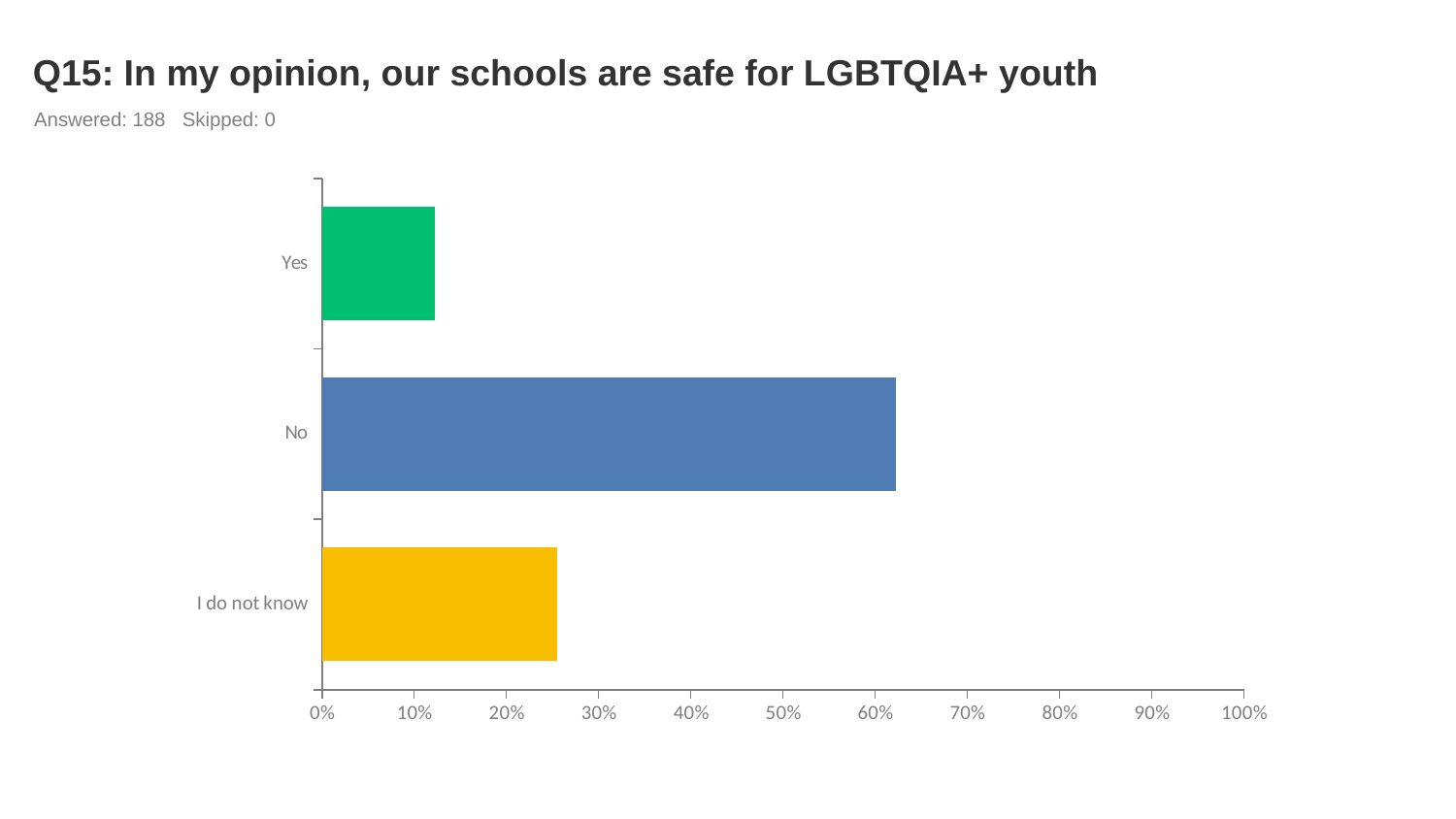
Which is larger, the value for "No" or the value for "I do not know"? No Is the value for "I do not know" greater or less than 30%? less Which response category has the lowest value? Yes Is the value for "I do not know" greater or less than 20%? greater How many respondents answered the question according to the slide? 188 Is the value for "Yes" greater or less than 20%? less How many response categories are shown in the chart? 3 Which is larger, the value for "Yes" or the value for "I do not know"? I do not know Which response category has the highest value? No What is the title of the chart? Q15: In my opinion, our schools are safe for LGBTQIA+ youth What kind of chart is shown on the slide? bar chart